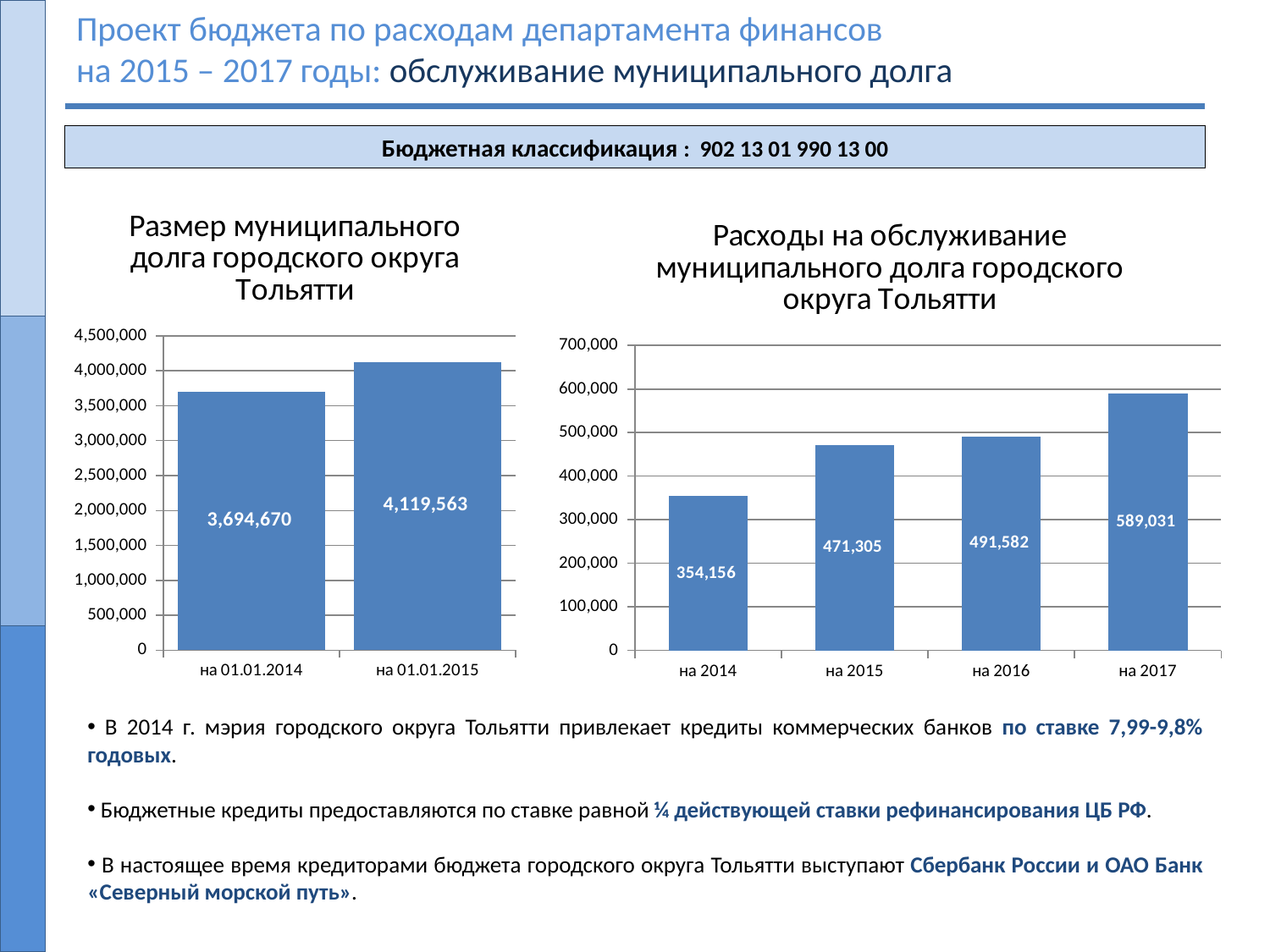
In the left chart 'Размер муниципального долга городского округа Тольятти', how many bars are plotted? 2 In the left chart 'Размер муниципального долга городского округа Тольятти', what is the value for 'на 01.01.2014'? 3,694,670 In the right chart 'Расходы на обслуживание муниципального долга городского округа Тольятти', what is the difference between the values for 'на 2017' and 'на 2014'? 234,875 In the left chart 'Размер муниципального долга городского округа Тольятти', what is the difference between the values for 'на 01.01.2015' and 'на 01.01.2014'? 424,893 In the right chart 'Расходы на обслуживание муниципального долга городского округа Тольятти', what is the value for 'на 2016'? 491,582 In the right chart 'Расходы на обслуживание муниципального долга городского округа Тольятти', is the value for 'на 2015' greater or less than 400,000? greater In the right chart 'Расходы на обслуживание муниципального долга городского округа Тольятти', which category has the lowest value? на 2014 In the right chart 'Расходы на обслуживание муниципального долга городского округа Тольятти', which category has the highest value? на 2017 In the left chart 'Размер муниципального долга городского округа Тольятти', what is the value for 'на 01.01.2015'? 4,119,563 In the right chart 'Расходы на обслуживание муниципального долга городского округа Тольятти', do the values rise or fall from 'на 2014' to 'на 2017'? rise In the right chart 'Расходы на обслуживание муниципального долга городского округа Тольятти', how many categories are shown on the x axis? 4 What kind of chart is the right chart 'Расходы на обслуживание муниципального долга городского округа Тольятти'? bar chart